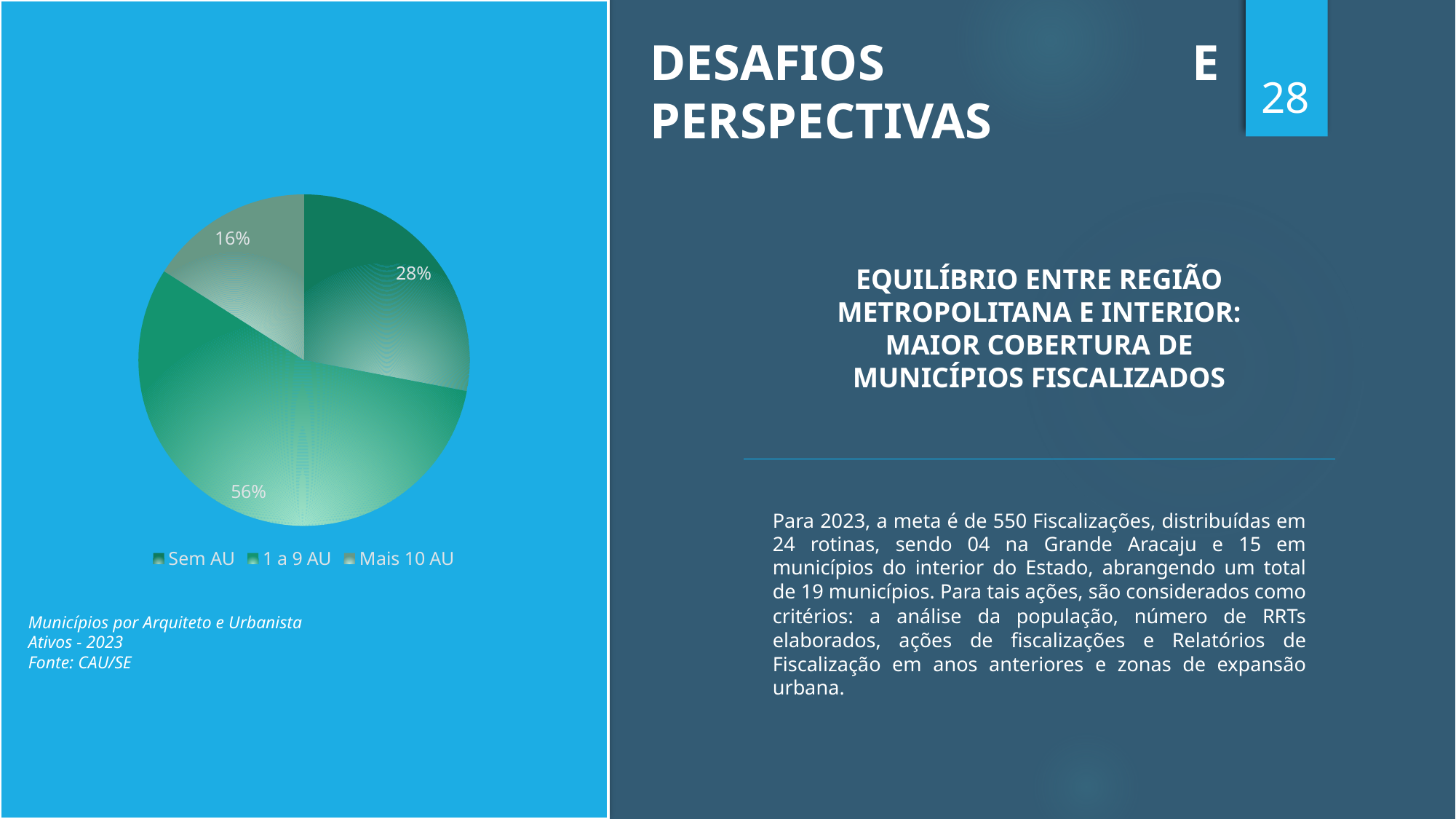
What kind of chart is shown on the slide? pie chart How many entries does the chart legend list? 3 Which is larger, the "Sem AU" slice or the "Mais 10 AU" slice? Sem AU What share of the pie does the "Mais 10 AU" slice represent? 16% What is the difference in percentage points between the "Sem AU" slice and the "Mais 10 AU" slice? 12 Which category has the smallest slice of the pie? Mais 10 AU How many slices does the pie chart have? 3 Which category has the largest slice of the pie? 1 a 9 AU What share of the pie does the "1 a 9 AU" slice represent? 56% What is the difference in percentage points between the "1 a 9 AU" slice and the "Sem AU" slice? 28 What source is cited for the chart data? CAU/SE What share of the pie does the "Sem AU" slice represent? 28%